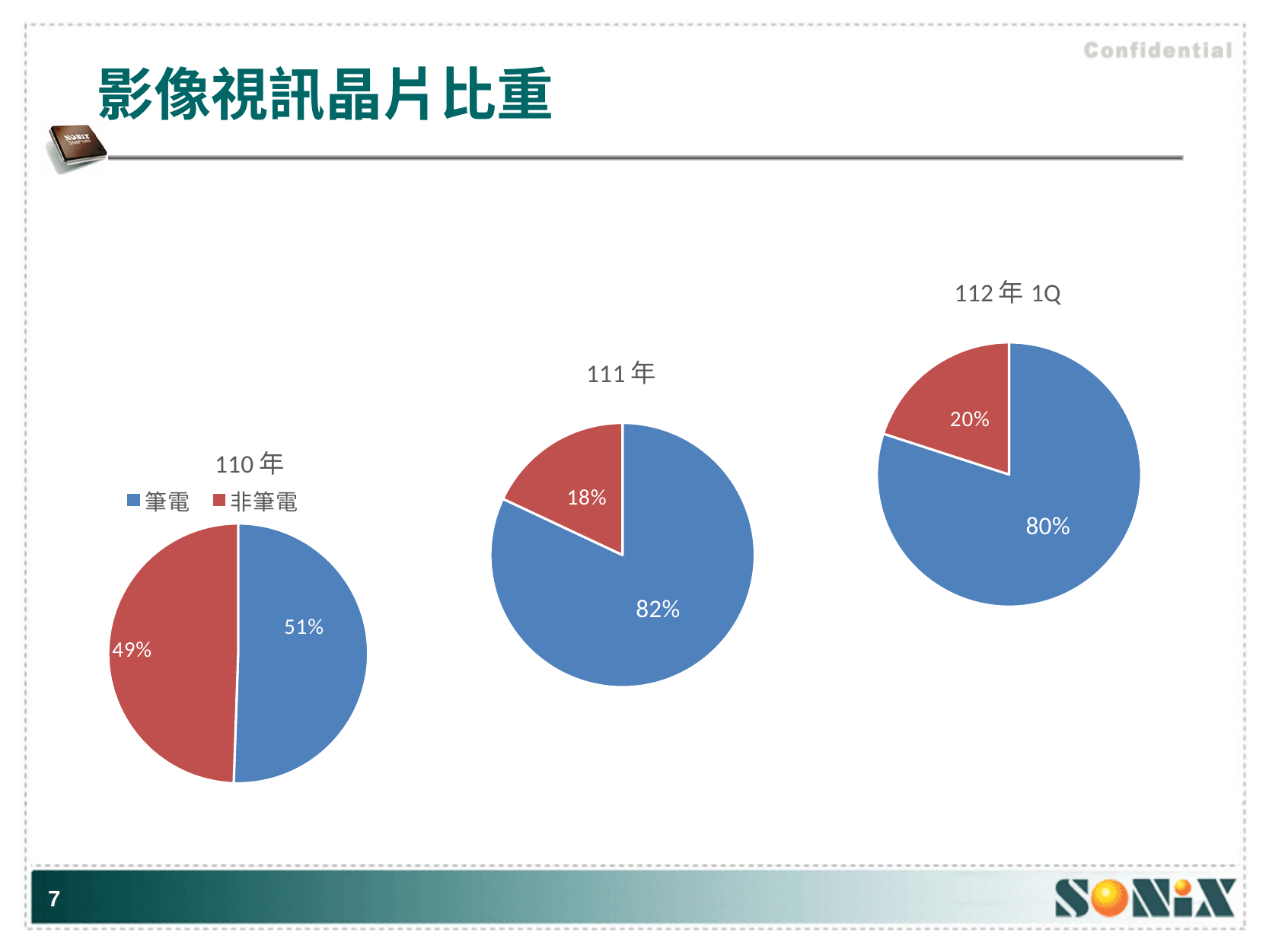
In the 112 年 1Q pie chart, what share does 筆電 have? 80% In the 110 年 pie chart, what share does 筆電 have? 51% In the 111 年 pie chart, which slice is larger, 筆電 or 非筆電? 筆電 What kind of chart is used on this slide? Pie chart In the 111 年 pie chart, what share does 筆電 have? 82% How many pie charts are shown on the slide? 3 How many series does the legend list? 2 In the 112 年 1Q pie chart, what share does 非筆電 have? 20% In the 110 年 pie chart, what share does 非筆電 have? 49% In the 112 年 1Q pie chart, what is the difference between the 筆電 and 非筆電 shares? 60% In the 111 年 pie chart, what share does 非筆電 have? 18% In the 111 年 pie chart, what is the difference between the 筆電 and 非筆電 shares? 64%